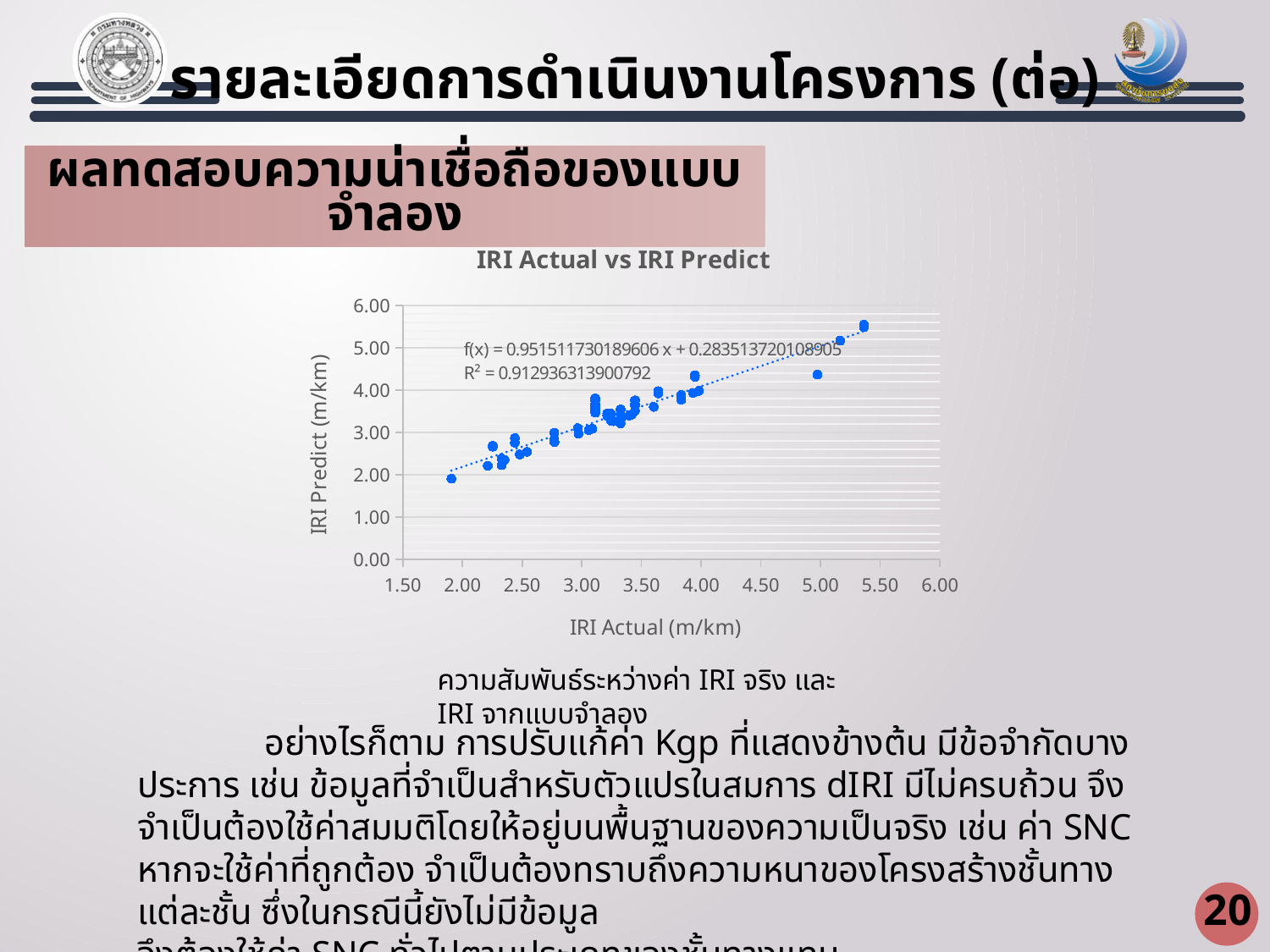
What is the intercept of the trendline equation printed on the chart? 0.283513720108905 What is the label of the x axis of the chart? IRI Actual (m/km) What R² value is printed on the chart? 0.912936313900792 Is the IRI Predict value of the point with the highest IRI Actual greater or less than 5.00? greater What is the slope of the trendline equation printed on the chart? 0.951511730189606 Is the IRI Predict value of the point with the lowest IRI Actual greater or less than 3.00? less Do the IRI Predict values generally rise or fall as IRI Actual increases? rise What is the title of the chart? IRI Actual vs IRI Predict Is the IRI Predict value of the point at about 5.00 IRI Actual greater or less than 4.00? greater What is the maximum value shown on the y axis of the chart? 6.00 What is the minimum value shown on the x axis of the chart? 1.50 What kind of chart is shown on the slide? scatter chart